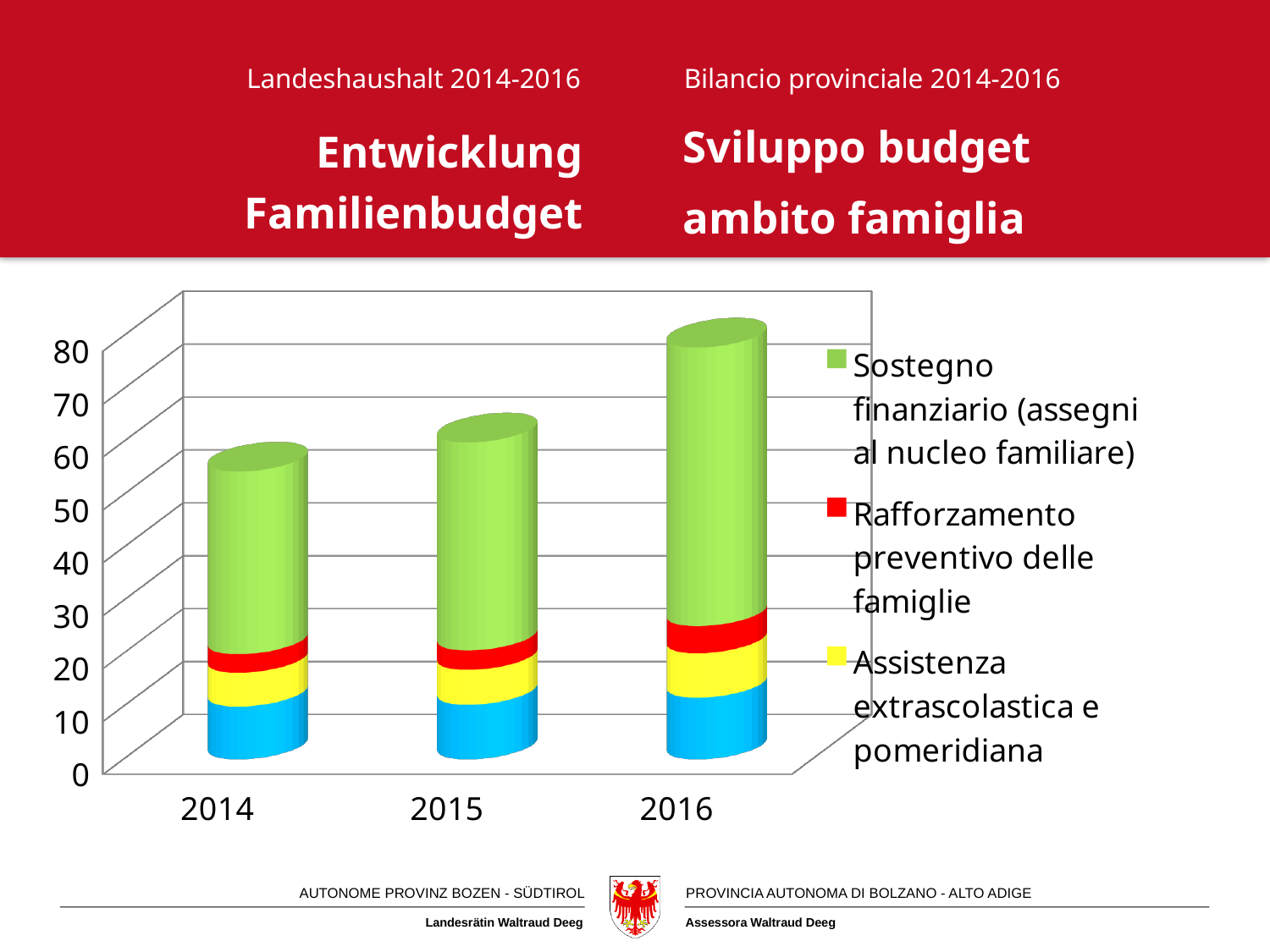
Do the total bar heights rise or fall from 2014 to 2016? rise Which year has the larger total bar, 2014 or 2016? 2016 Which legend entry is shown in red? Rafforzamento preventivo delle famiglie What kind of chart is shown on the slide? Stacked bar chart How many series does the chart's legend list? 3 What colour represents 'Sostegno finanziario (assegni al nucleo familiare)' in the legend? Green Is the total value of the 2016 bar greater or less than 70? greater How many years are shown on the x axis of the chart? 3 Which year has the tallest stacked bar? 2016 Which year has the shortest stacked bar? 2014 Is the total value of the 2014 bar greater or less than 70? less Is the total value of the 2015 bar greater or less than 50? greater